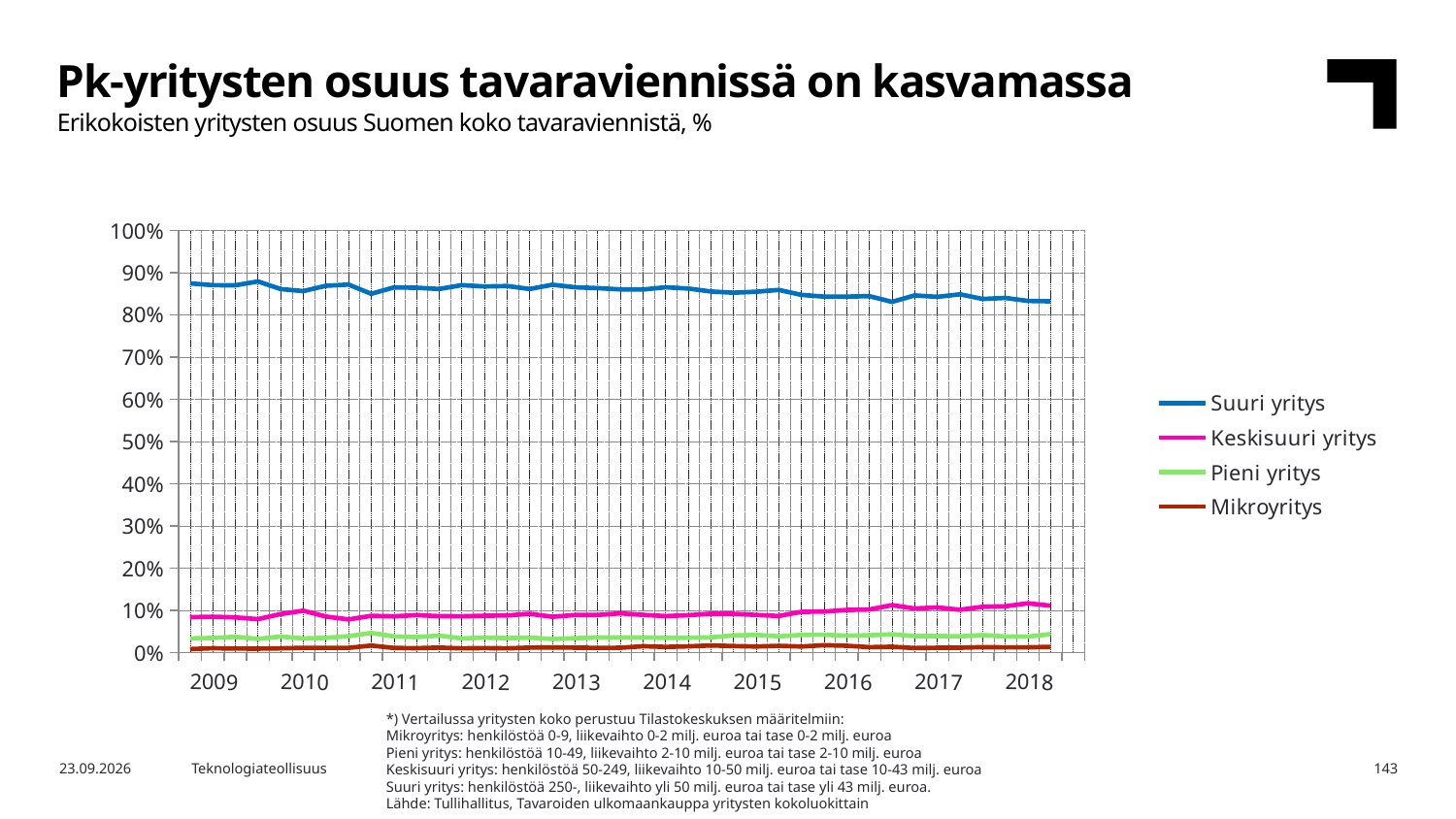
Which series has the highest share throughout the chart? Suuri yritys Does the Suuri yritys line rise or fall from 2009 to 2018? Fall Which series has the lowest share throughout the chart? Mikroyritys Is the value for Keskisuuri yritys in 2018 greater or less than 20%? less Which is larger in 2018, Suuri yritys or Keskisuuri yritys? Suuri yritys How many series does the legend list? 4 Is the value for Suuri yritys in 2009 greater or less than 80%? greater What colour is the Keskisuuri yritys line? Pink (magenta) What kind of chart is shown on the slide? Line chart What is the title of the slide? Pk-yritysten osuus tavaraviennissä on kasvamassa Is the value for Pieni yritys in 2015 greater or less than 10%? less How many years are labelled on the x axis? 10